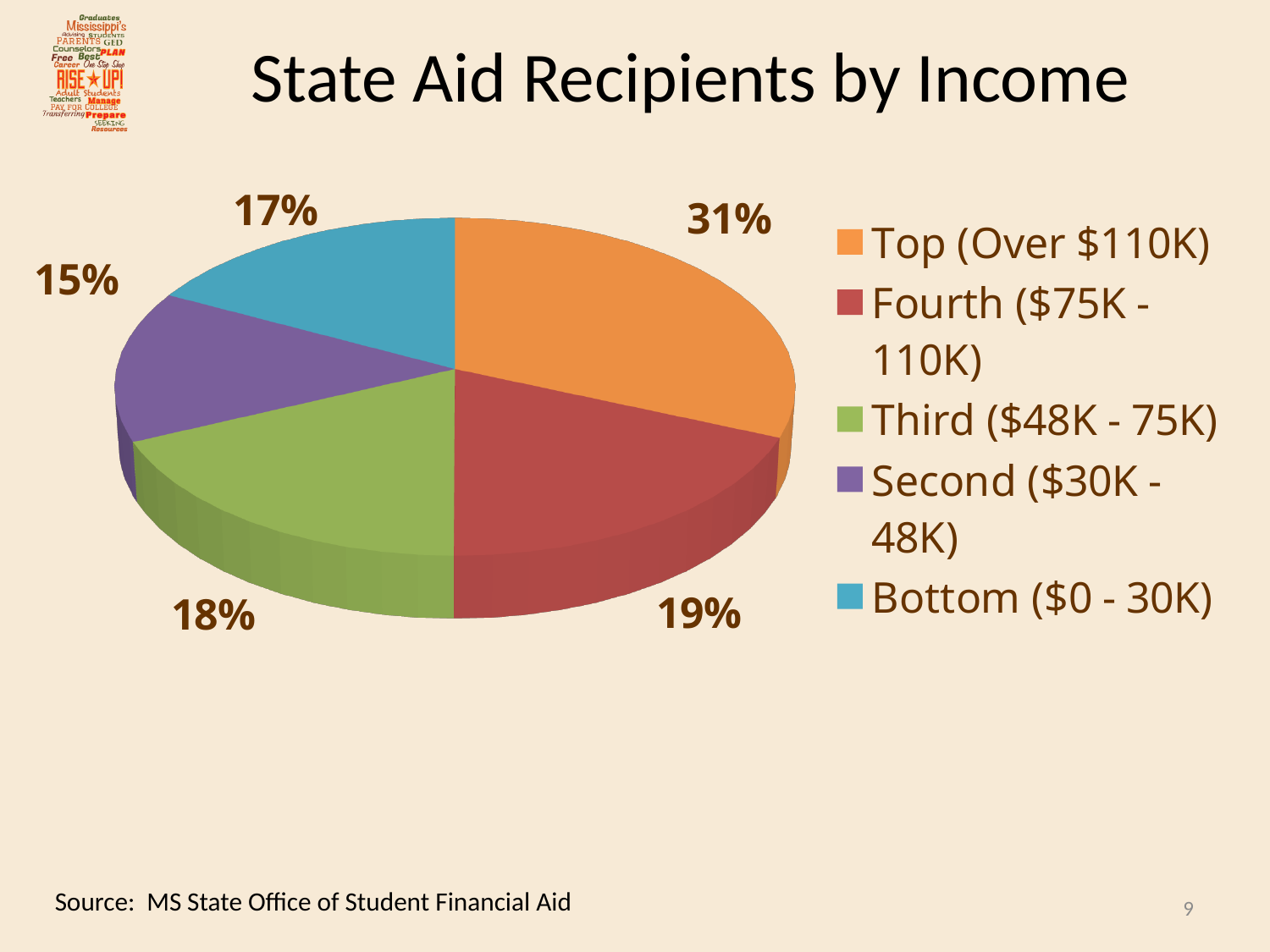
What colour represents the Fourth ($75K - 110K) group in the pie chart? Red How many percentage points larger is the Top (Over $110K) share than the Fourth ($75K - 110K) share? 12 What type of chart is shown on the slide? Pie chart What is the title of the chart? State Aid Recipients by Income Which income group has the largest share of state aid recipients? Top (Over $110K) What share of state aid recipients are in the Top (Over $110K) income group? 31% What percentage of state aid recipients fall in the Bottom ($0 - 30K) income group? 17% What is the share for the Second ($30K - 48K) income group? 15% Which income group has the smallest share of state aid recipients? Second ($30K - 48K) What percentage is shown for the Third ($48K - 75K) group? 18% How many income groups are shown in the pie chart? 5 Which has a larger share: Bottom ($0 - 30K) or Second ($30K - 48K)? Bottom ($0 - 30K)